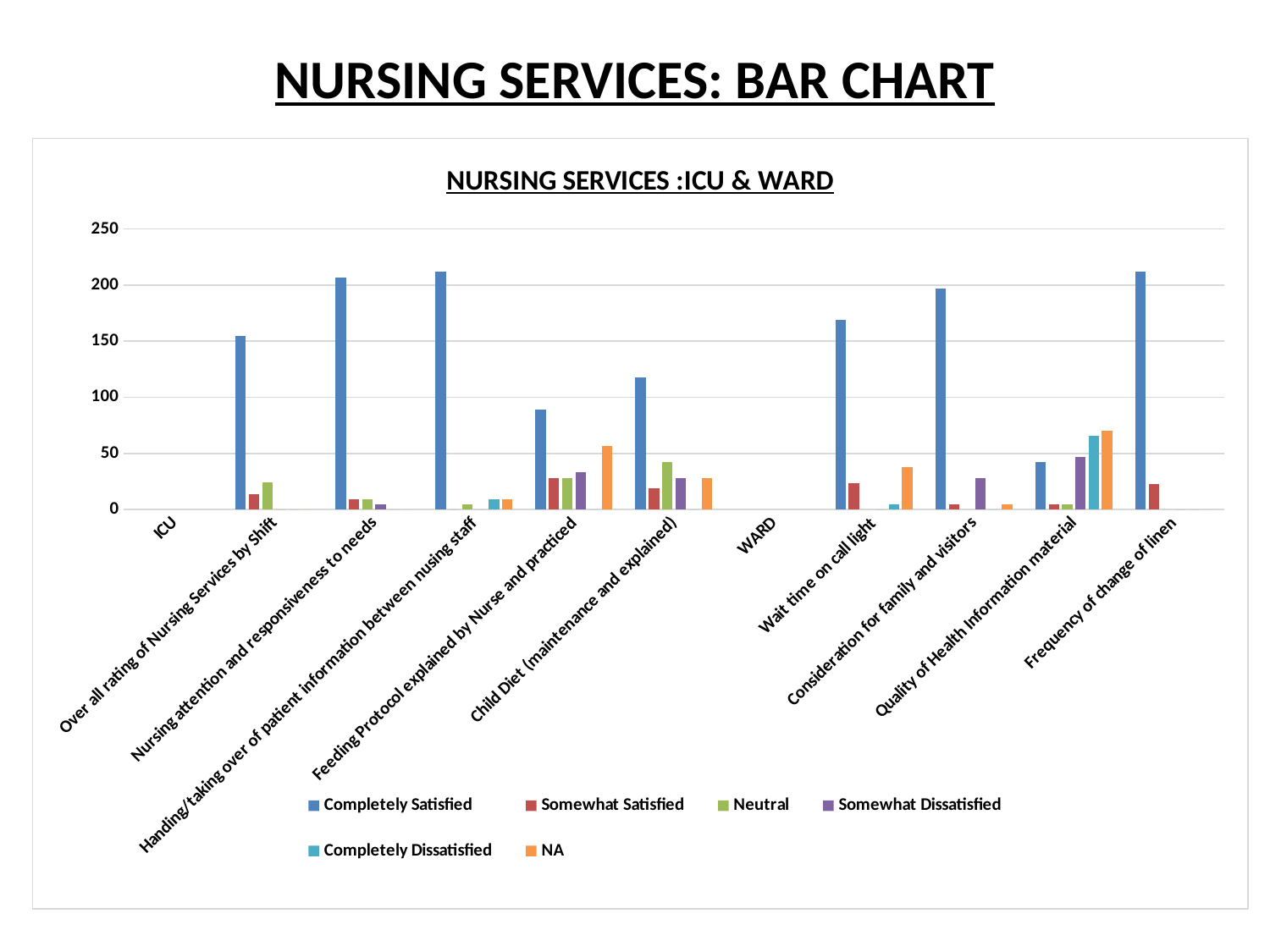
How many series does the legend list? 6 Is the Completely Satisfied value for Nursing attention and responsiveness to needs greater or less than 200? greater Is the Completely Satisfied value for Wait time on call light greater or less than 150? greater Is the NA value for Quality of Health Information material greater or less than 50? greater Which has the larger Completely Satisfied value: Consideration for family and visitors or Over all rating of Nursing Services by Shift? Consideration for family and visitors What is the title of the chart? NURSING SERVICES :ICU & WARD How many categories are shown along the x axis? 11 Which colour represents the Completely Satisfied series? Blue Which has the larger Completely Satisfied value: Wait time on call light or Child Diet (maintenance and explained)? Wait time on call light What kind of chart is shown on the slide? Bar chart